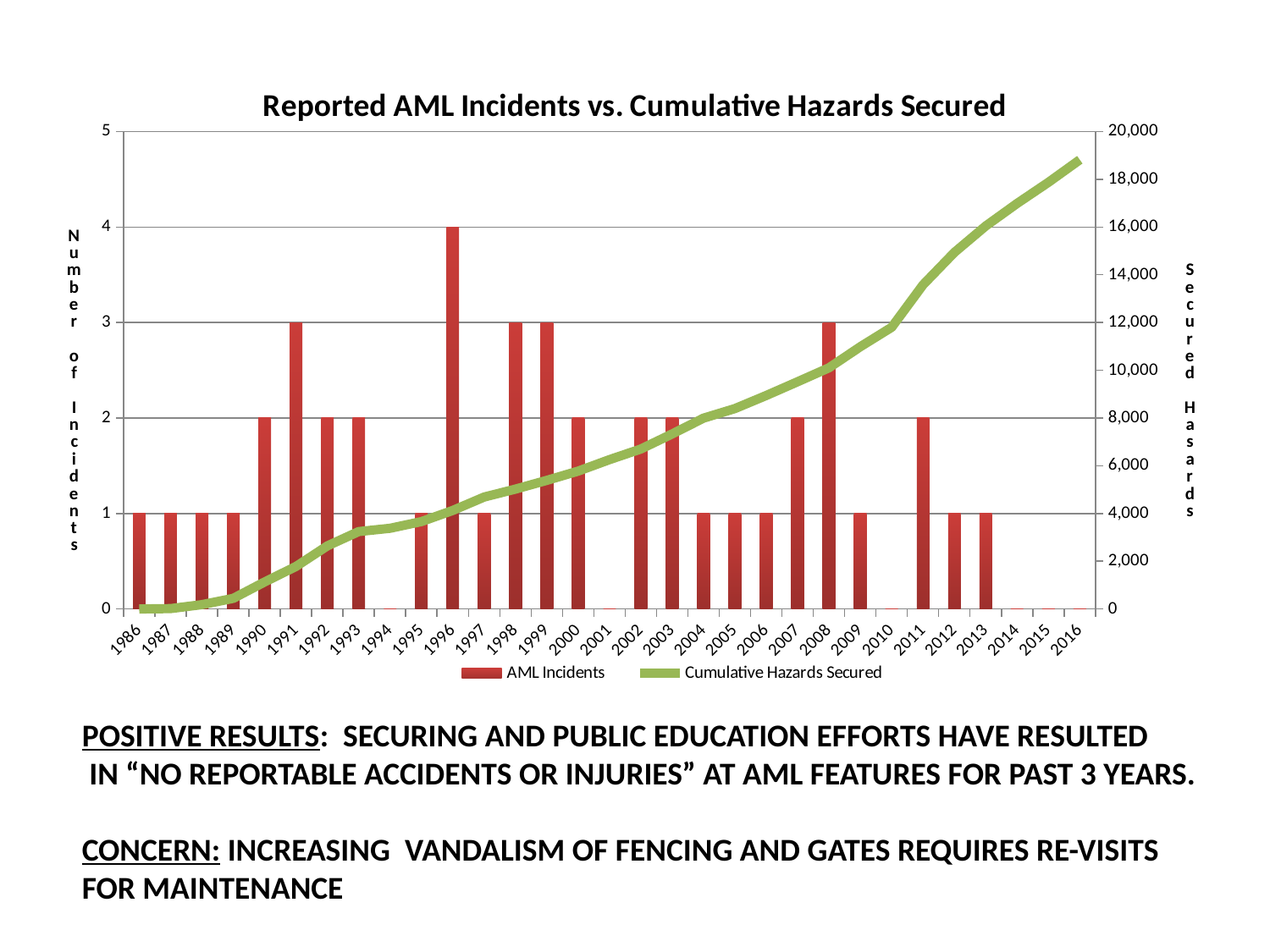
What is the difference between the AML Incidents in 1996 and in 1997? 3 Is the value of Cumulative Hazards Secured in 2016 greater or less than 18,000? greater How many AML Incidents were reported in 2008? 3 How many years are shown on the x axis? 31 Does the Cumulative Hazards Secured line rise or fall from 1986 to 2016? rise Which year had more AML Incidents, 1991 or 1992? 1991 How many AML Incidents were reported in 1996? 4 How many series does the legend list? 2 Which year has the highest number of AML Incidents? 1996 Is the value of Cumulative Hazards Secured in 2011 greater or less than 12,000? greater What is the title of the chart? Reported AML Incidents vs. Cumulative Hazards Secured How many AML Incidents were reported in 2011? 2